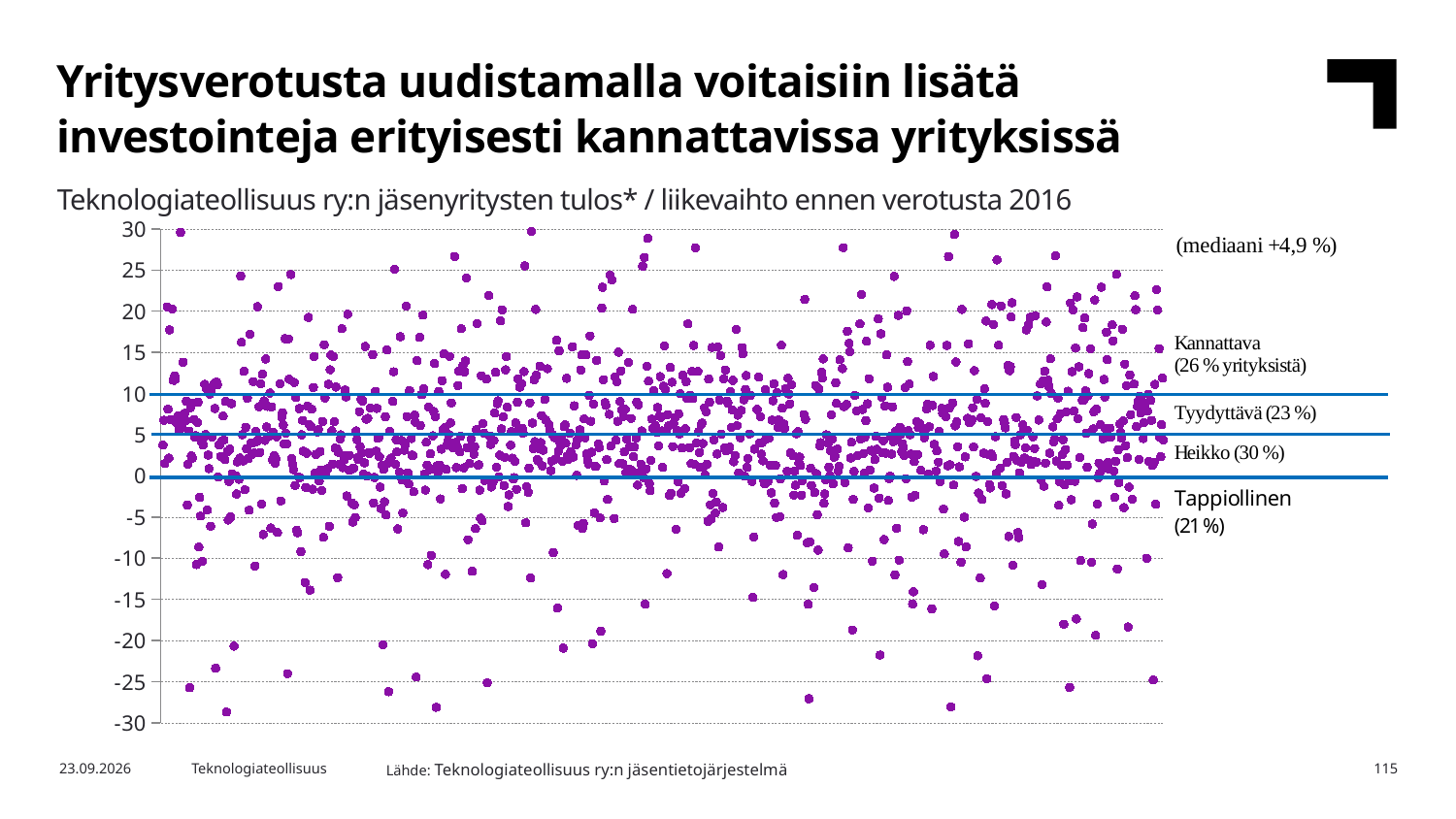
What is the highest value shown on the vertical axis? 30 What share of companies falls into the Heikko category? 30 % What share of companies falls into the Tyydyttävä category? 23 % What share of companies falls into the Kannattava category? 26 % Which category has the largest share of companies? Heikko What kind of chart is shown on the slide? Scatter plot Which category has the smallest share of companies? Tappiollinen What share of companies falls into the Tappiollinen category? 21 % What is the median value (mediaani) stated on the chart? +4,9 % What is the difference in percentage points between the Heikko share and the Tappiollinen share? 9 Is the median value shown on the chart greater or less than 5? less Which category has a larger share of companies, Kannattava or Tyydyttävä? Kannattava